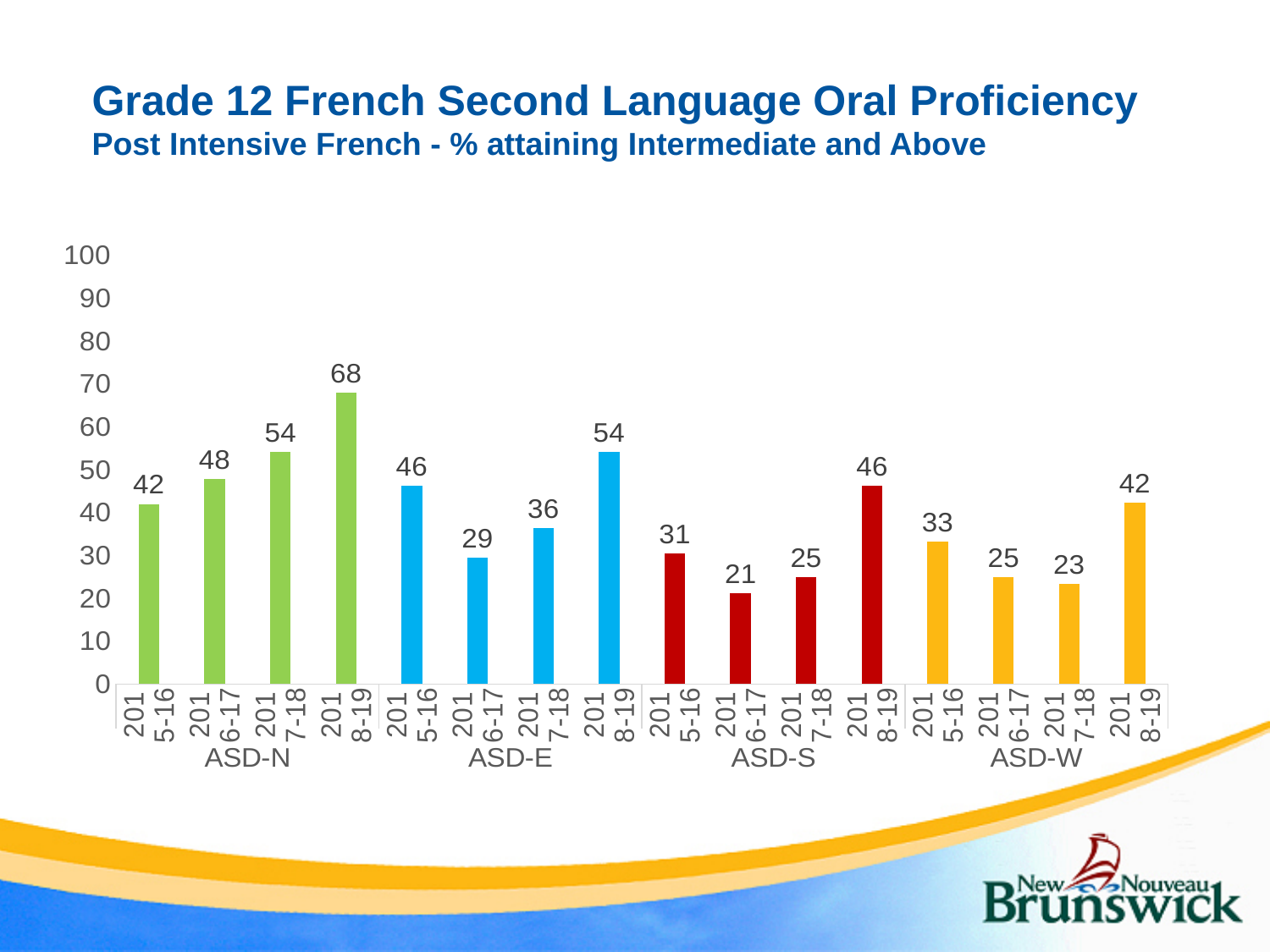
What is the value for ASD-E in 2016-17? 29 What is the value for ASD-N in 2018-19? 68 Is the value for ASD-S in 2018-19 greater or less than 40? greater How many bars are plotted on the chart? 16 Which is larger: the ASD-E 2017-18 value or the ASD-W 2015-16 value? ASD-E 2017-18 What is the difference between the ASD-N 2018-19 value and the ASD-N 2015-16 value? 26 What kind of chart is shown on the slide? Bar chart Which district and year has the lowest value on the chart? ASD-S, 2016-17 Which district and year has the highest value on the chart? ASD-N, 2018-19 What is the value for ASD-W in 2017-18? 23 What is the value for ASD-S in 2015-16? 31 Do the values for ASD-N rise or fall from 2015-16 to 2018-19? Rise